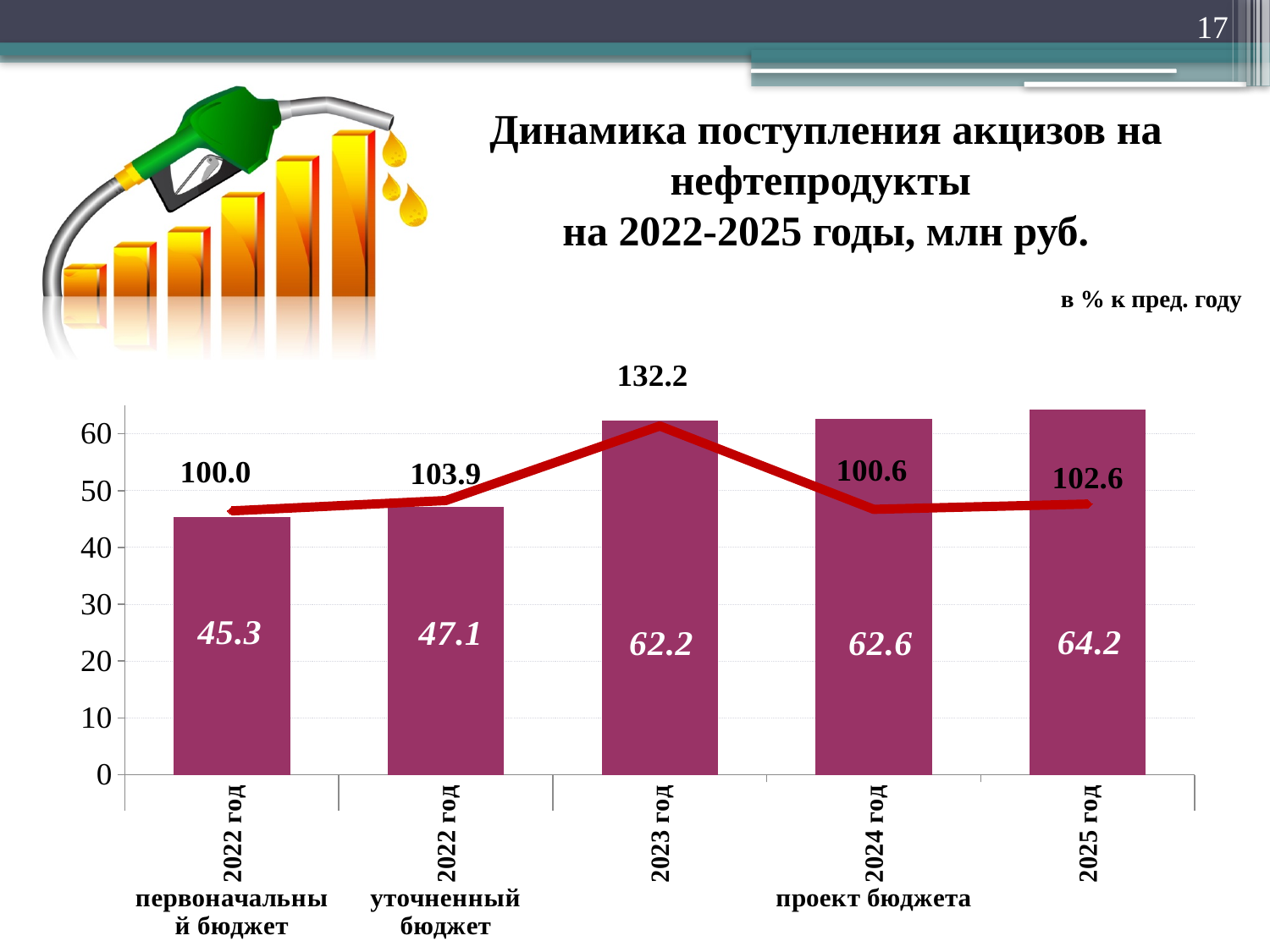
Which is larger: the bar value for 2022 год (уточненный бюджет) or for 2023 год? 2023 год What is the value of the bar for 2025 год? 64.2 What is the title of the chart? Динамика поступления акцизов на нефтепродукты на 2022-2025 годы, млн руб. What is the value of the line (в % к пред. году) for 2022 год (уточненный бюджет)? 103.9 Do the bar values rise or fall from 2022 год to 2025 год? rise What is the value of the bar for 2022 год (первоначальный бюджет)? 45.3 What is the value of the line (в % к пред. году) for 2023 год? 132.2 Which category has the lowest bar value? 2022 год (первоначальный бюджет) How many bars are shown in the chart? 5 What is the value of the bar for 2023 год? 62.2 What is the difference between the bar values for 2025 год and 2022 год (первоначальный бюджет)? 18.9 Which category has the highest bar value? 2025 год